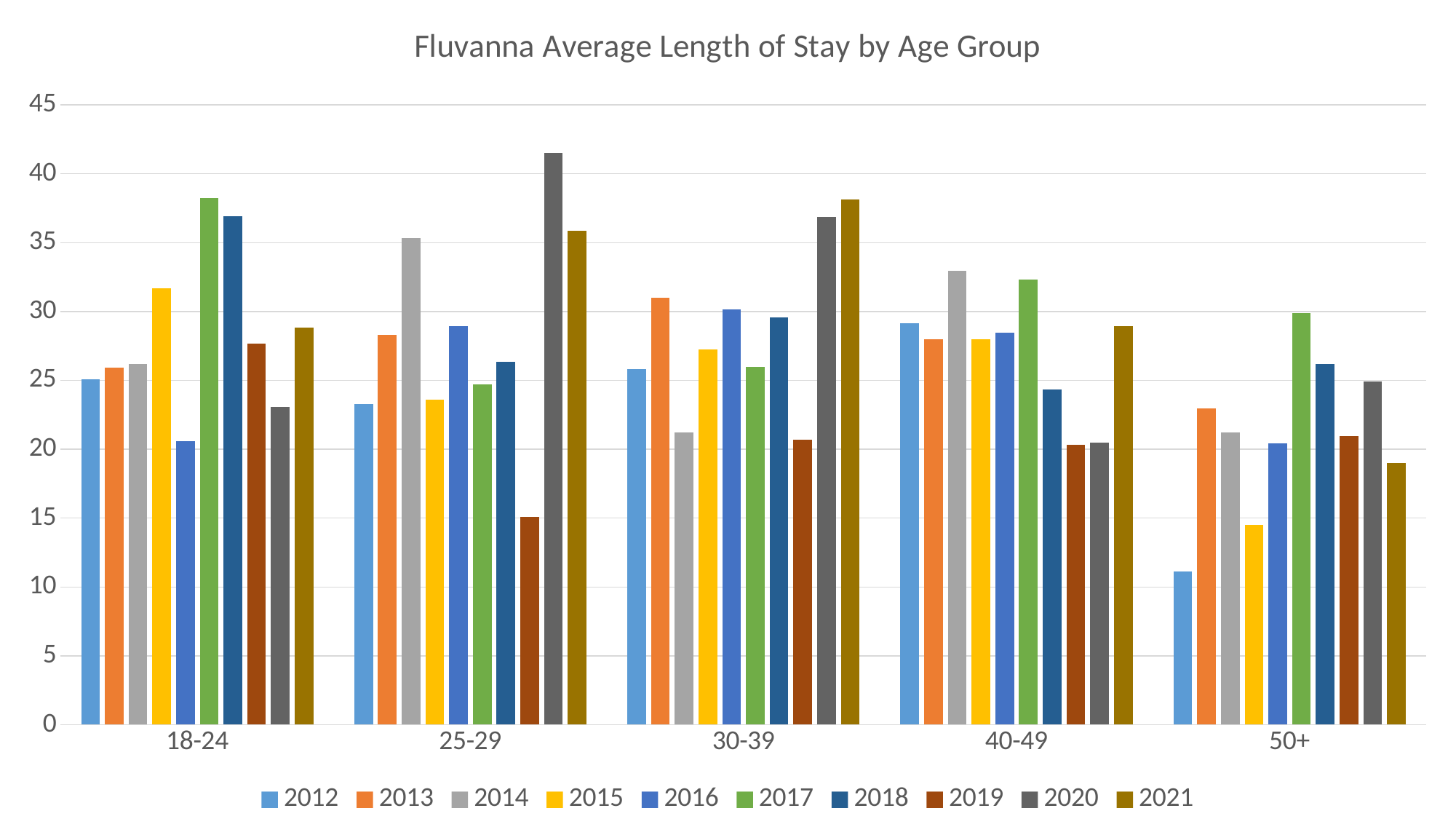
Within the 18-24 age group, which year has the highest bar? 2017 In the 18-24 age group, which is larger: the 2017 bar or the 2016 bar? 2017 How many age groups are shown on the x axis? 5 Which age group has the highest bar for 2020? 25-29 Within the 50+ age group, which year has the lowest bar? 2012 Is the value for 2012 in the 50+ age group greater or less than 15? less What kind of chart is shown on the slide? bar chart Is the value for 2019 in the 25-29 age group greater or less than 20? less How many series does the legend list? 10 Which age group has the lowest bar for 2012? 50+ What is the title of the chart? Fluvanna Average Length of Stay by Age Group Is the value for 2020 in the 25-29 age group greater or less than 40? greater